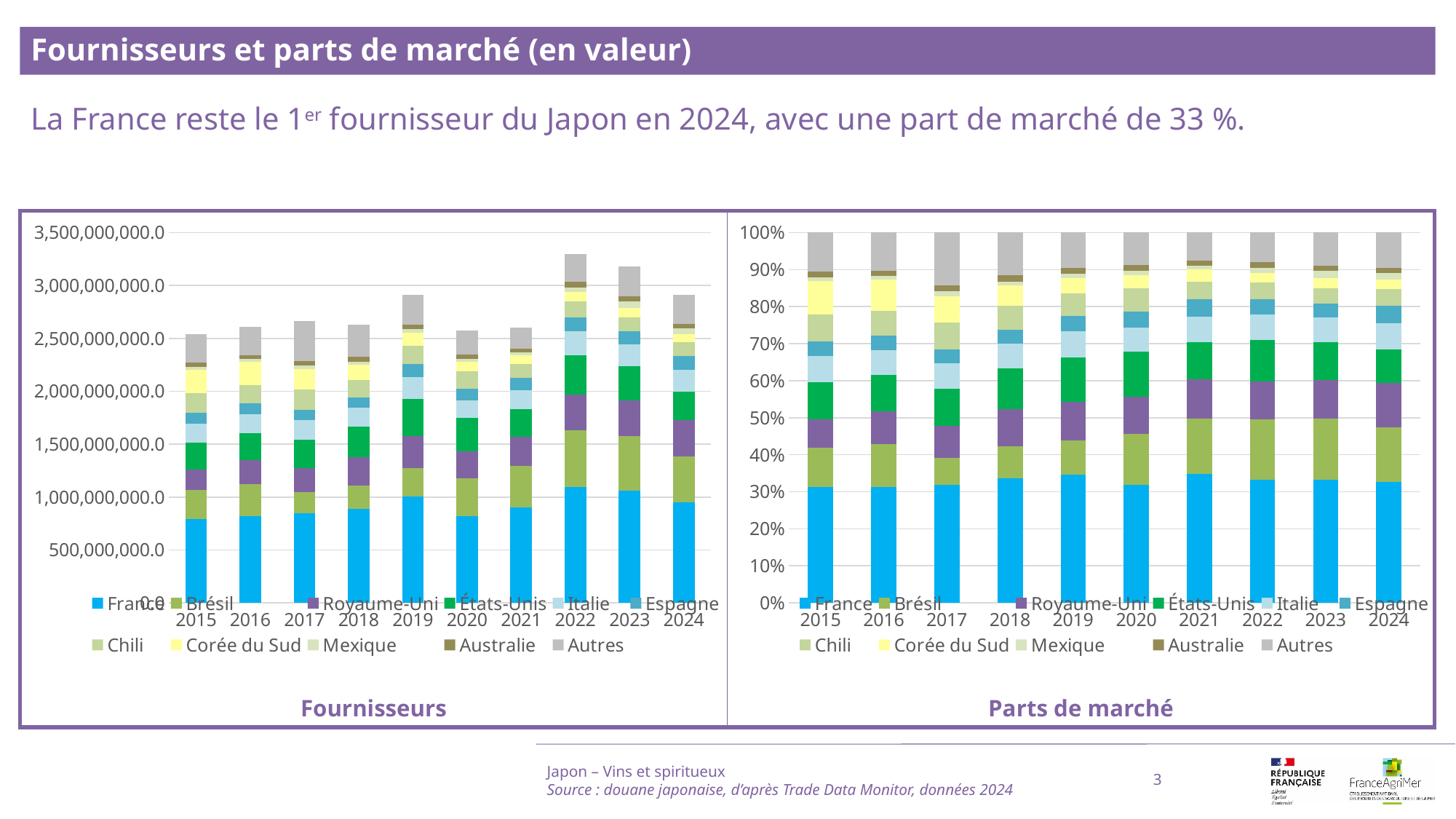
Which series is listed first in the legend of the 'Parts de marché' chart? France In the 'Fournisseurs' chart, do the total bars rise or fall from 2015 to 2019? rise What kind of chart is the 'Fournisseurs' chart on the left? Stacked bar chart In the 'Fournisseurs' chart, is the total bar for 2022 greater or less than 3,000,000,000.0? greater In the 'Fournisseurs' chart, is the France segment for 2015 greater or less than 1,000,000,000.0? less In the 'Parts de marché' chart, is the France share for 2019 greater or less than 30%? greater How many years are shown on the x axis of the 'Parts de marché' chart? 10 In the 'Fournisseurs' chart, which year has the highest total bar? 2022 How many series does the legend of the 'Fournisseurs' chart list? 11 In the 'Fournisseurs' chart, which total bar is taller, 2022 or 2023? 2022 What is the title shown below the right-hand chart? Parts de marché